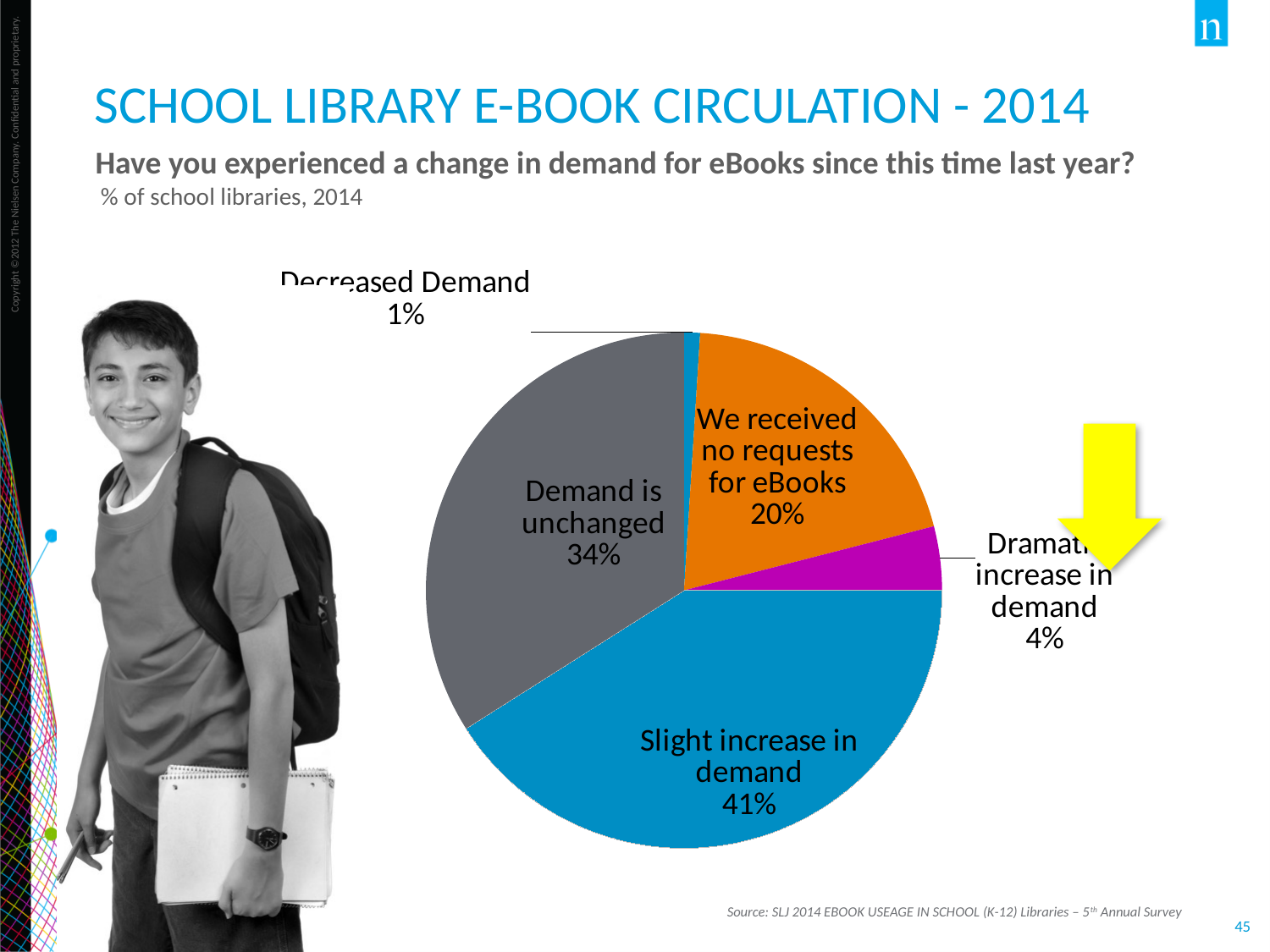
What share of school libraries received no requests for eBooks? 20% How many percentage points higher is 'Slight increase in demand' than 'Demand is unchanged'? 7 What percentage of school libraries reported a slight increase in demand for eBooks? 41% What is the combined share of libraries reporting either a slight or a dramatic increase in demand? 45% Which response has the smallest share of the pie? Decreased Demand What type of chart is shown on the slide? Pie chart What percentage of school libraries reported decreased demand? 1% Which response has the largest share of the pie? Slight increase in demand What percentage of school libraries reported a dramatic increase in demand? 4% Which is larger: the share for 'We received no requests for eBooks' or the share for 'Dramatic increase in demand'? We received no requests for eBooks What percentage of school libraries said demand is unchanged? 34% How many response categories are shown in the pie chart? 5